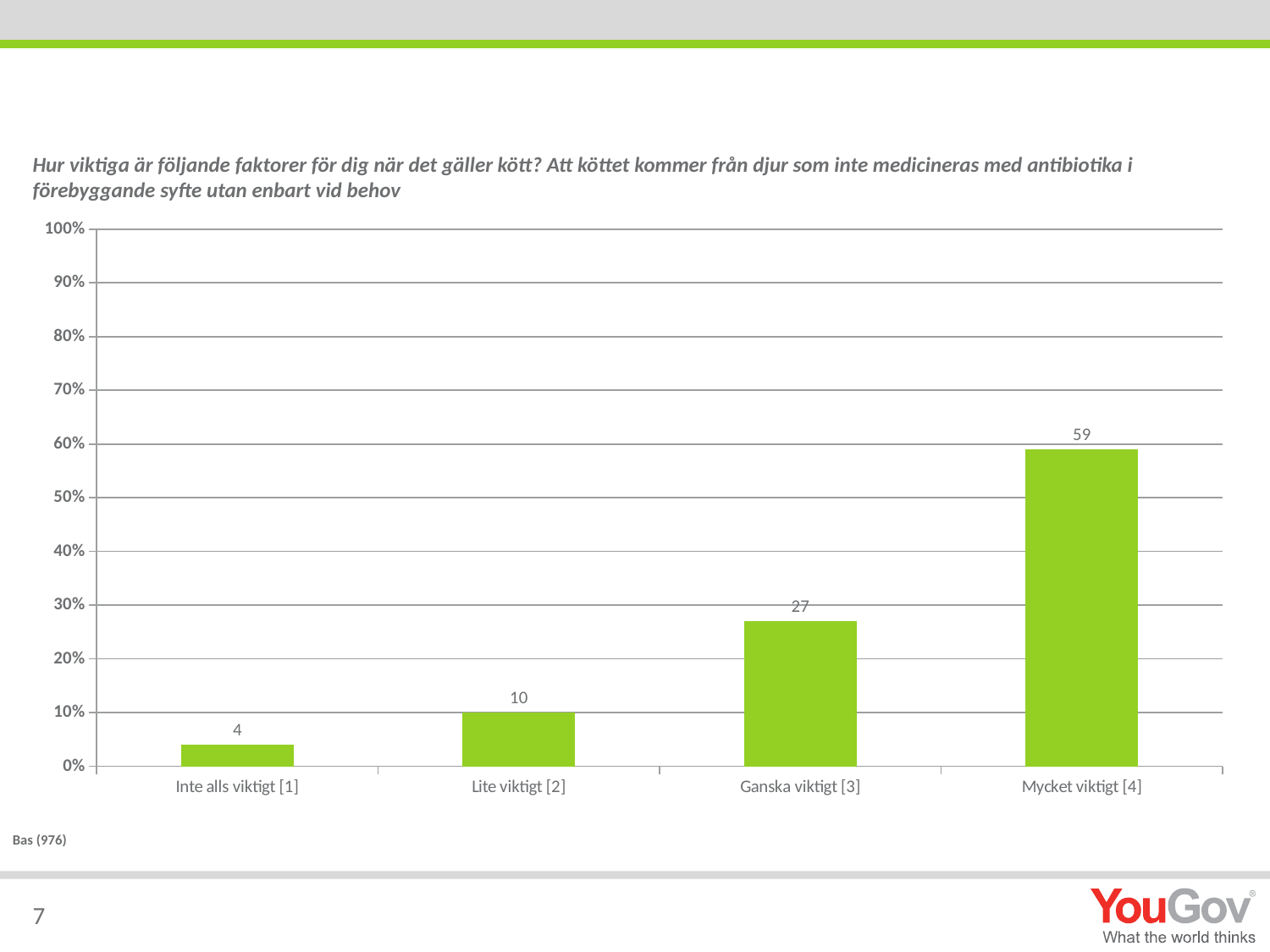
What is the value for Lite viktigt [2]? 10 What is the value for Mycket viktigt [4]? 59 Do the values rise or fall from left to right along the x axis? rise What kind of chart is shown on the slide? bar chart Which category has the highest value? Mycket viktigt [4] Is the value for Mycket viktigt [4] greater or less than 50%? greater What is the value for Ganska viktigt [3]? 27 What is the value for Inte alls viktigt [1]? 4 Which category has the lowest value? Inte alls viktigt [1] How many categories are shown on the x axis? 4 Which is larger, the value for Lite viktigt [2] or Ganska viktigt [3]? Ganska viktigt [3] What is the difference between the values for Mycket viktigt [4] and Ganska viktigt [3]? 32